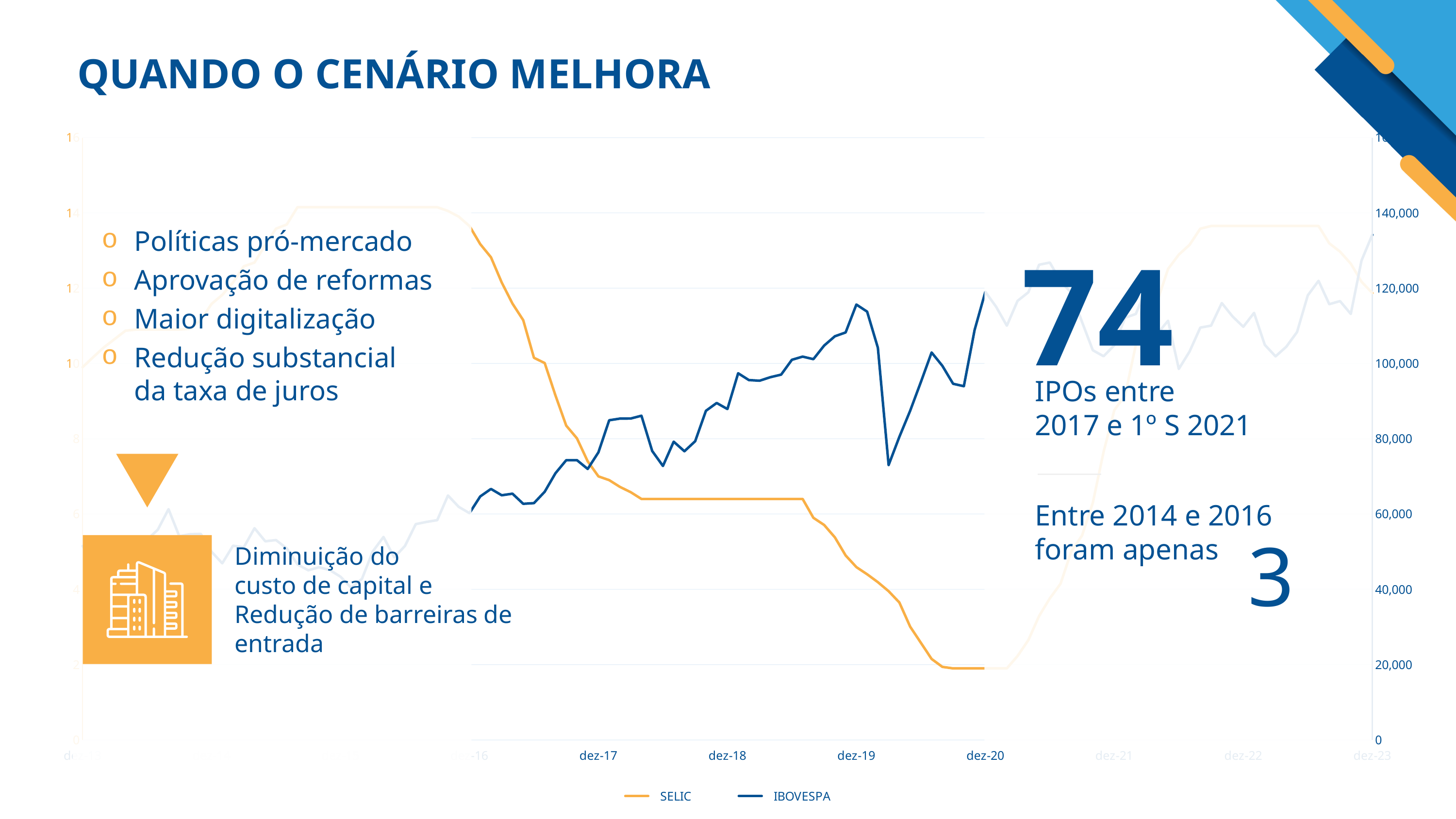
Which series is higher on its own axis at dez-20: SELIC (left axis, 0–16) or IBOVESPA (right axis, 0–160,000), in terms of position on the chart? IBOVESPA Is the SELIC value at dez-18 greater or less than 8 on the left axis? less Which series is drawn in orange in the chart? SELIC Is the SELIC value at dez-16 greater or less than 12 on the left axis? greater Is the IBOVESPA value at dez-20 greater or less than 100,000 on the right axis? greater What kind of chart is shown on the slide? line chart Which series is drawn in dark blue in the chart? IBOVESPA How many series does the chart legend list? 2 Does the SELIC line rise or fall between dez-16 and dez-20? fall Does the IBOVESPA line rise or fall overall between dez-16 and dez-20? rise